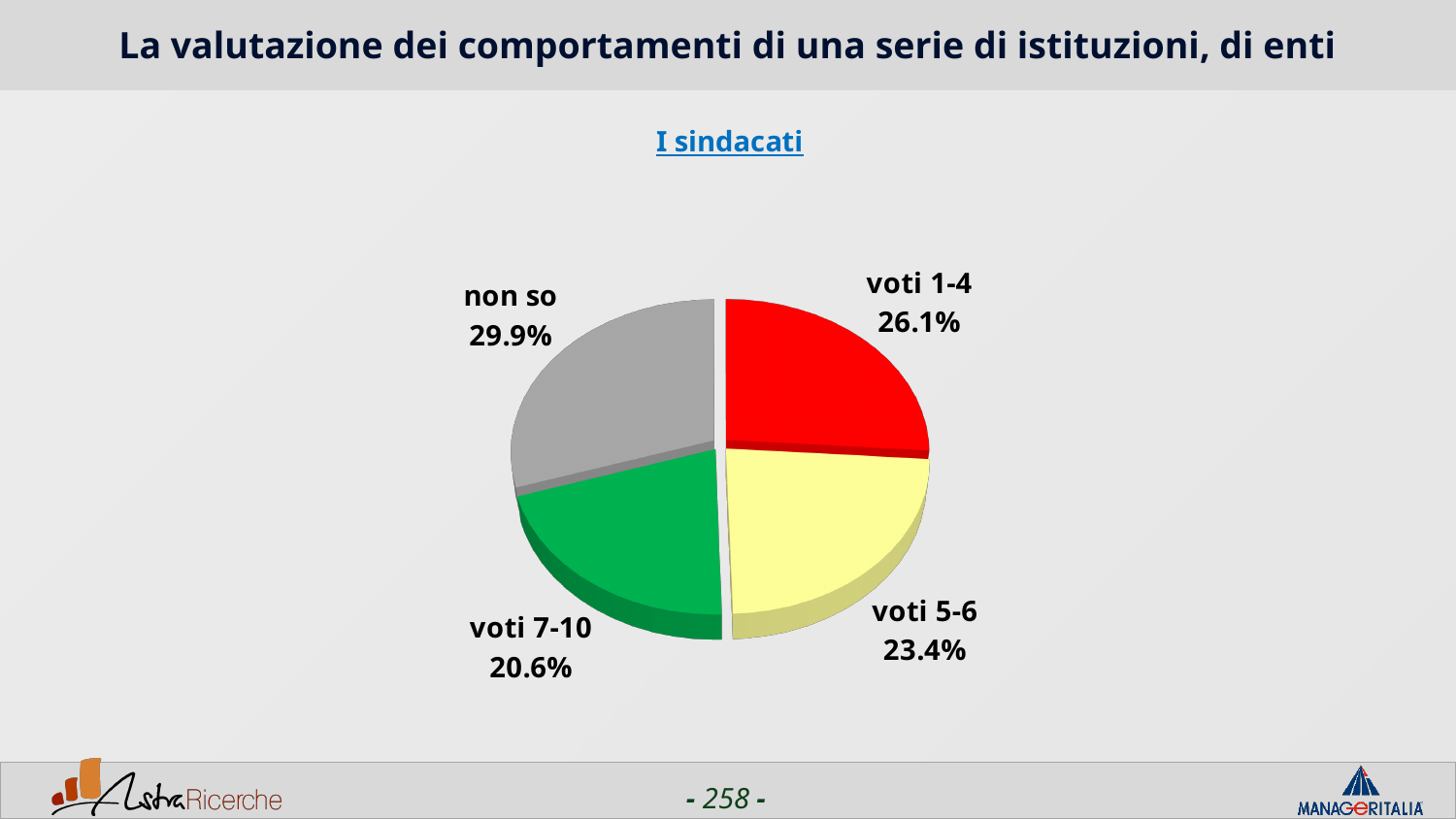
Which is larger, the value for 'voti 1-4' or the value for 'voti 7-10'? voti 1-4 Which category has the largest share of the pie? non so What is the difference between the values for 'voti 1-4' and 'voti 5-6'? 2.7% What is the value for 'voti 1-4'? 26.1% What is the value for 'voti 7-10'? 20.6% What is the difference between the values for 'non so' and 'voti 7-10'? 9.3% How many slices does the pie chart have? 4 What is the value for 'voti 5-6'? 23.4% What kind of chart is shown on the slide? pie chart What is the value for 'non so'? 29.9% Which category has the smallest share of the pie? voti 7-10 What is the subtitle of the chart? I sindacati